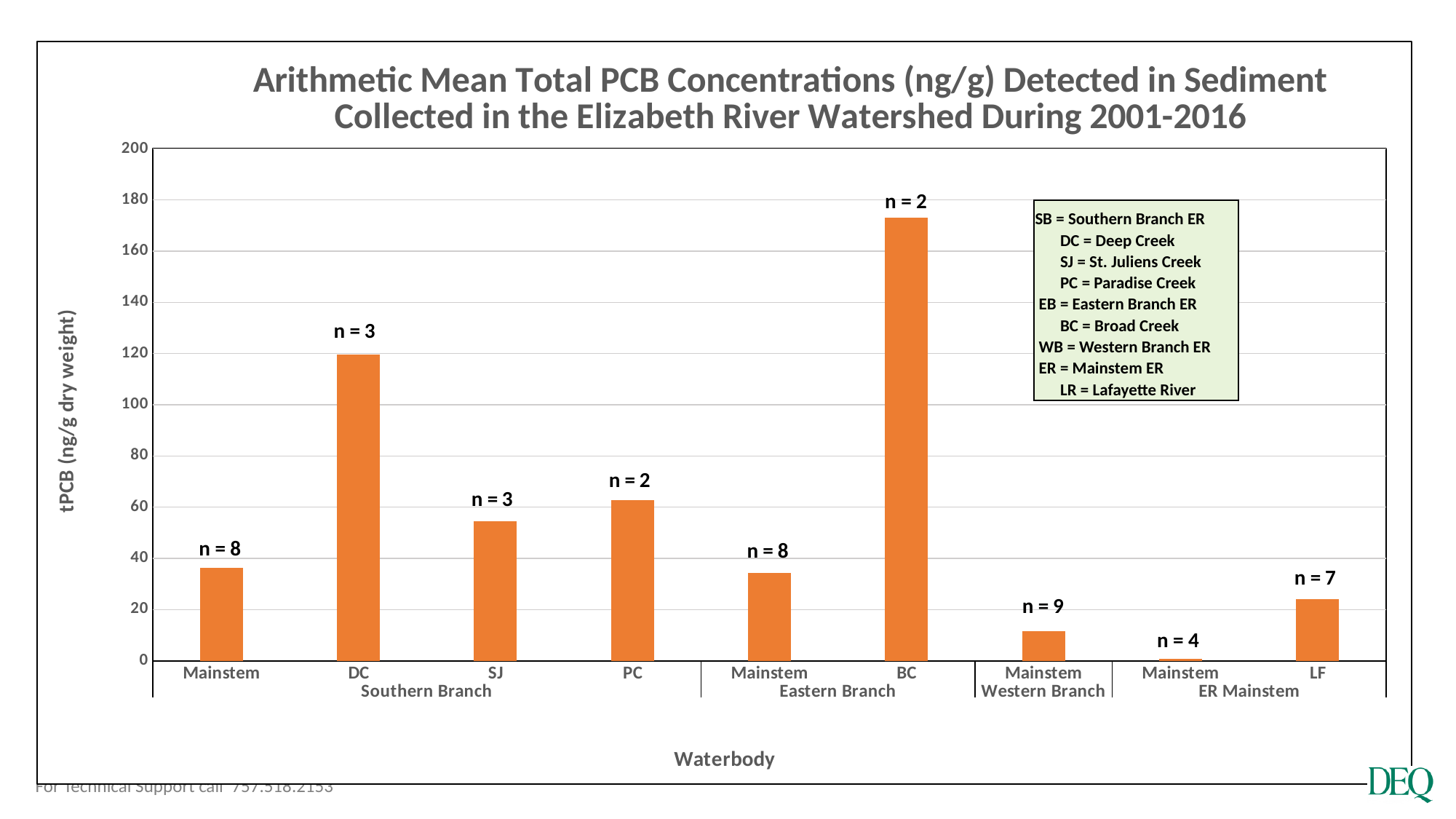
What is the label on the y axis? tPCB (ng/g dry weight) Which has a higher mean total PCB concentration, DC or PC? DC Is the value for BC greater or less than 160? greater Is the value for the Western Branch Mainstem greater or less than 20? less Which waterbody has the highest mean total PCB concentration? BC (Eastern Branch) Which waterbody has the lowest mean total PCB concentration? Mainstem (ER Mainstem) Is the value for SJ greater or less than 60? less How many bars are plotted in the chart? 9 What sample size (n) is shown above the LF bar? n = 7 What kind of chart is shown on the slide? bar chart What sample size (n) is shown above the DC bar? n = 3